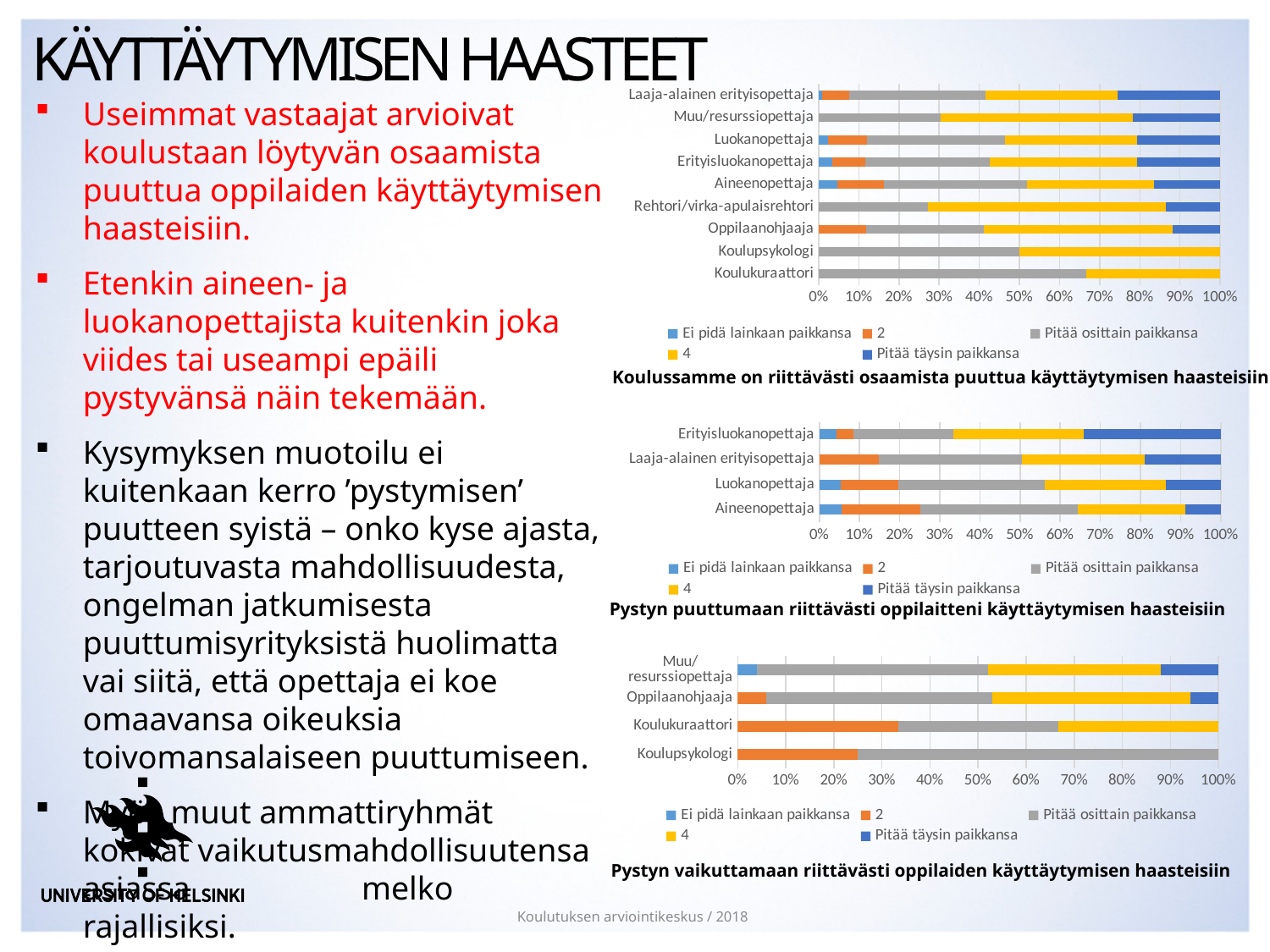
In the chart 'Pystyn vaikuttamaan riittävästi oppilaiden käyttäytymisen haasteisiin', is the '2' share for Koulupsykologi greater or less than 30%? less In the chart 'Pystyn puuttumaan riittävästi oppilaitteni käyttäytymisen haasteisiin', which category has the largest 'Pitää täysin paikkansa' share? Erityisluokanopettaja In the chart 'Pystyn vaikuttamaan riittävästi oppilaiden käyttäytymisen haasteisiin', which has the larger 'Pitää osittain paikkansa' share: Koulupsykologi or Koulukuraattori? Koulupsykologi In the chart 'Pystyn vaikuttamaan riittävästi oppilaiden käyttäytymisen haasteisiin', is the 'Pitää osittain paikkansa' share for Koulupsykologi greater or less than 70%? greater What is the title of the bottom chart on the slide? Pystyn vaikuttamaan riittävästi oppilaiden käyttäytymisen haasteisiin In the chart 'Pystyn vaikuttamaan riittävästi oppilaiden käyttäytymisen haasteisiin', which category has the largest 'Pitää osittain paikkansa' share? Koulupsykologi How many categories are shown in the chart 'Koulussamme on riittävästi osaamista puuttua käyttäytymisen haasteisiin'? 9 How many categories are shown in the chart 'Pystyn vaikuttamaan riittävästi oppilaiden käyttäytymisen haasteisiin'? 4 What kind of chart is used for 'Koulussamme on riittävästi osaamista puuttua käyttäytymisen haasteisiin'? Stacked bar chart How many series does the legend list in the chart 'Pystyn puuttumaan riittävästi oppilaitteni käyttäytymisen haasteisiin'? 5 In the chart 'Pystyn vaikuttamaan riittävästi oppilaiden käyttäytymisen haasteisiin', which category has the largest '2' share? Koulukuraattori What is the last entry in the legend of the chart 'Koulussamme on riittävästi osaamista puuttua käyttäytymisen haasteisiin'? Pitää täysin paikkansa